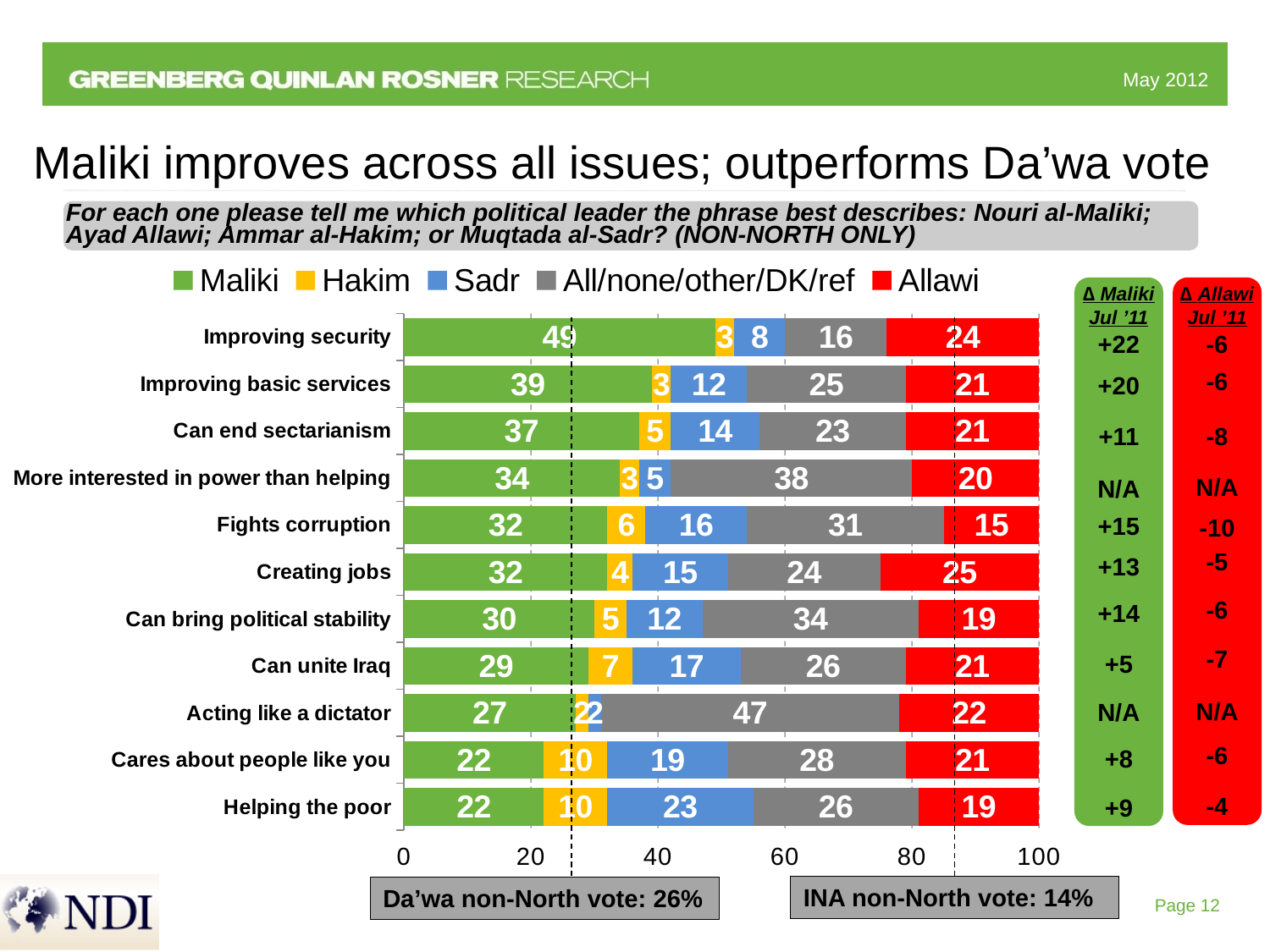
What is the Maliki value for "Improving security"? 49 What is the All/none/other/DK/ref value for "Acting like a dictator"? 47 What is the difference between the Maliki value and the Allawi value for "Improving basic services"? 18 How many categories (phrases) are plotted on the chart? 11 Which category has the lowest Allawi value? Fights corruption What is the Allawi value for "Fights corruption"? 15 What is the total of the stacked bar for "Can unite Iraq"? 100 Which category has the highest Maliki value? Improving security What is the Sadr value for "Helping the poor"? 23 How many series does the legend list? 5 What kind of chart is shown on the slide? Stacked bar chart Which is larger for "Creating jobs": the Maliki value or the Allawi value? Maliki